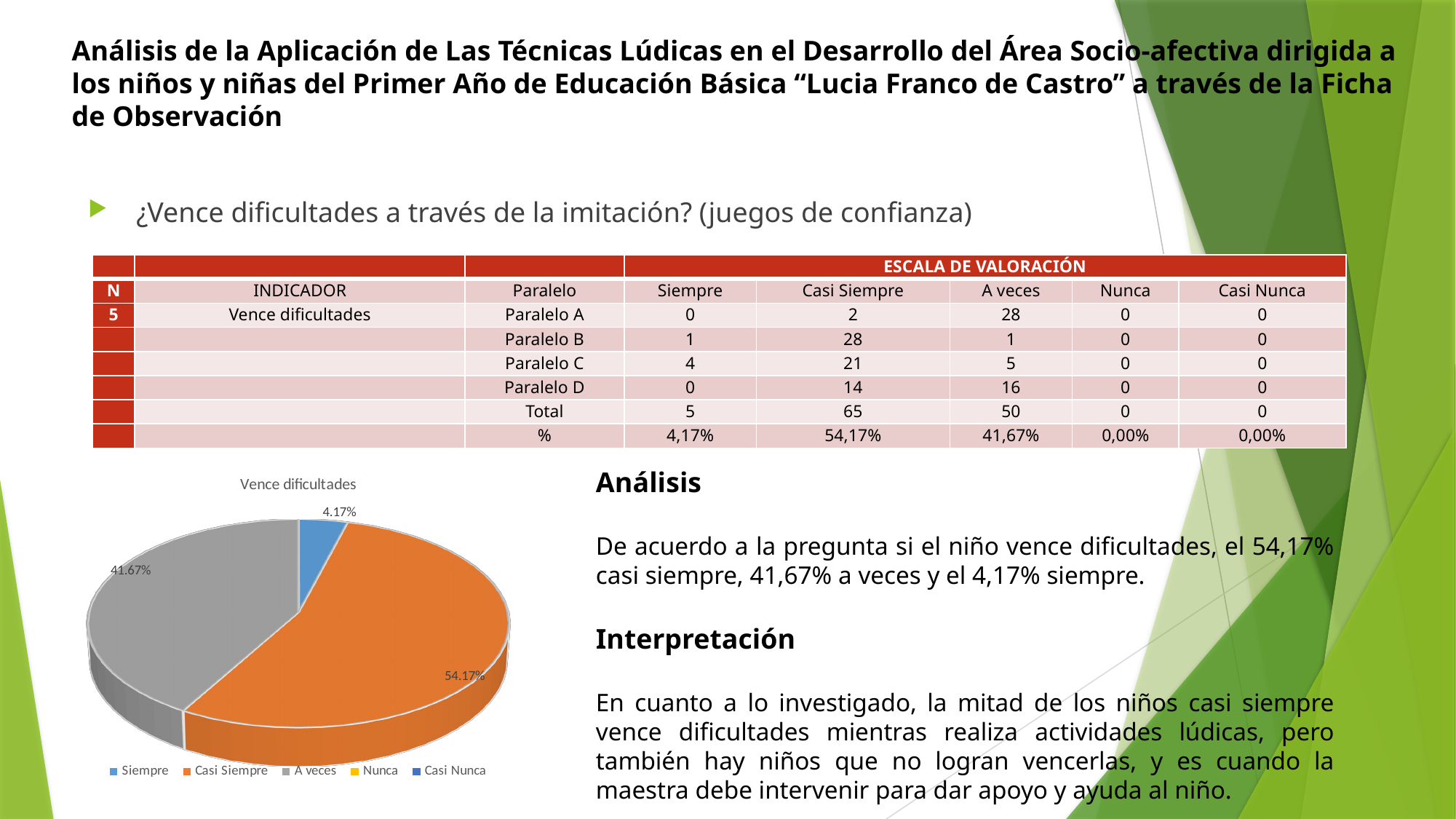
What percentage does the Casi Siempre slice show in the pie chart? 54.17% What type of chart is shown on the slide? pie chart What percentage does the Siempre slice show in the pie chart? 4.17% What percentage does the A veces slice show in the pie chart? 41.67% How many slices with a visible data label are shown in the pie chart? 3 How many entries does the legend of the pie chart list? 5 Which of the visible slices in the pie chart is the smallest? Siempre What colour is the Casi Siempre slice in the pie chart? orange What is the title of the pie chart? Vence dificultades Which slice is larger in the pie chart, Casi Siempre or A veces? Casi Siempre Which category has the largest slice in the pie chart? Casi Siempre What is the difference in percentage points between the Casi Siempre slice and the A veces slice? 12.50%